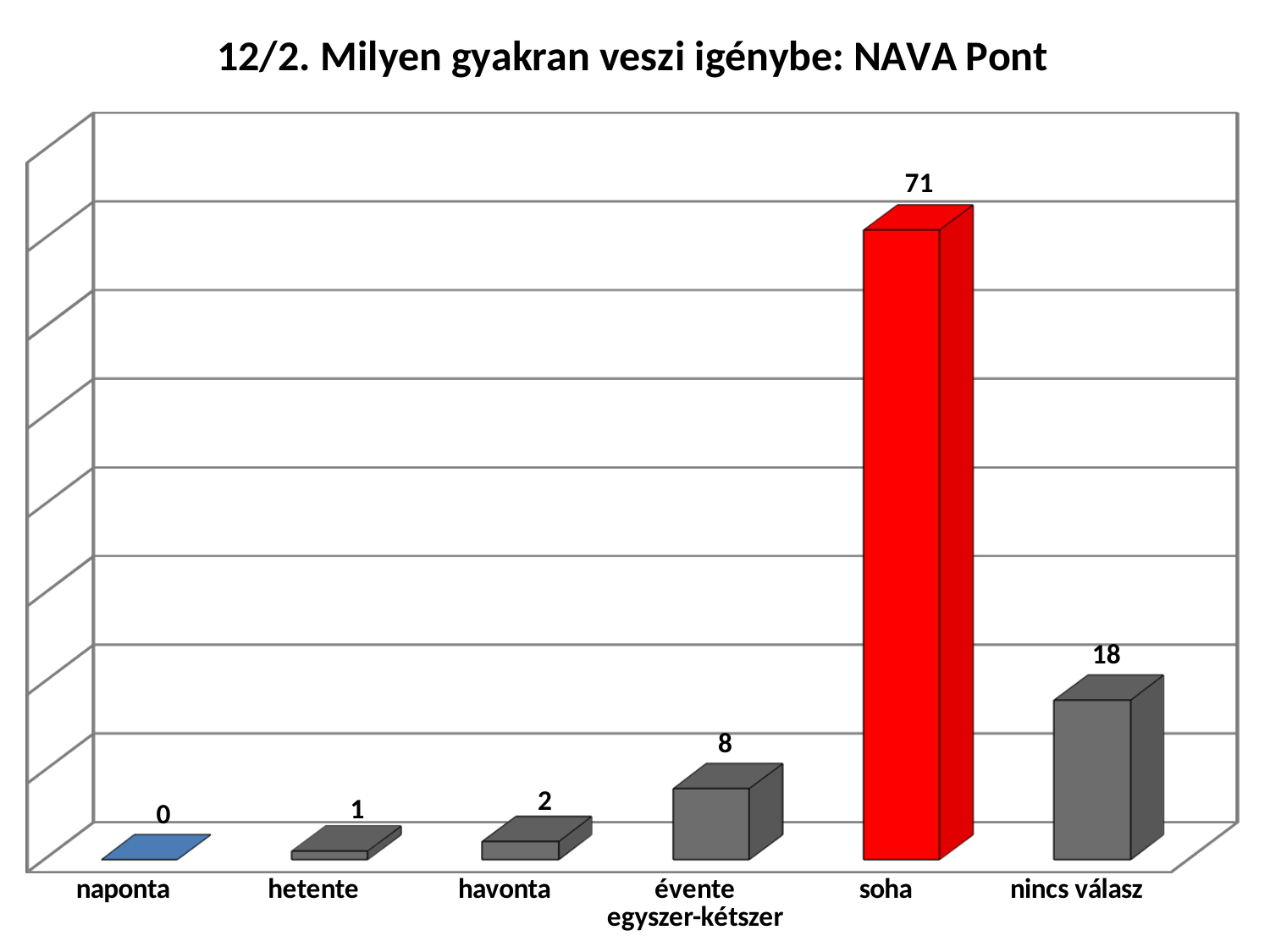
What kind of chart is shown on the slide? bar chart What is the difference between the values for "évente egyszer-kétszer" and "havonta"? 6 How many categories are shown on the x axis? 6 What is the value for "soha"? 71 What is the value for "évente egyszer-kétszer"? 8 Which is larger, the value for "hetente" or the value for "havonta"? havonta What is the value for "nincs válasz"? 18 Which category has the lowest value? naponta What is the value for "naponta"? 0 Which category has the highest value? soha What is the difference between the values for "soha" and "nincs válasz"? 53 What is the title of the chart? 12/2. Milyen gyakran veszi igénybe: NAVA Pont